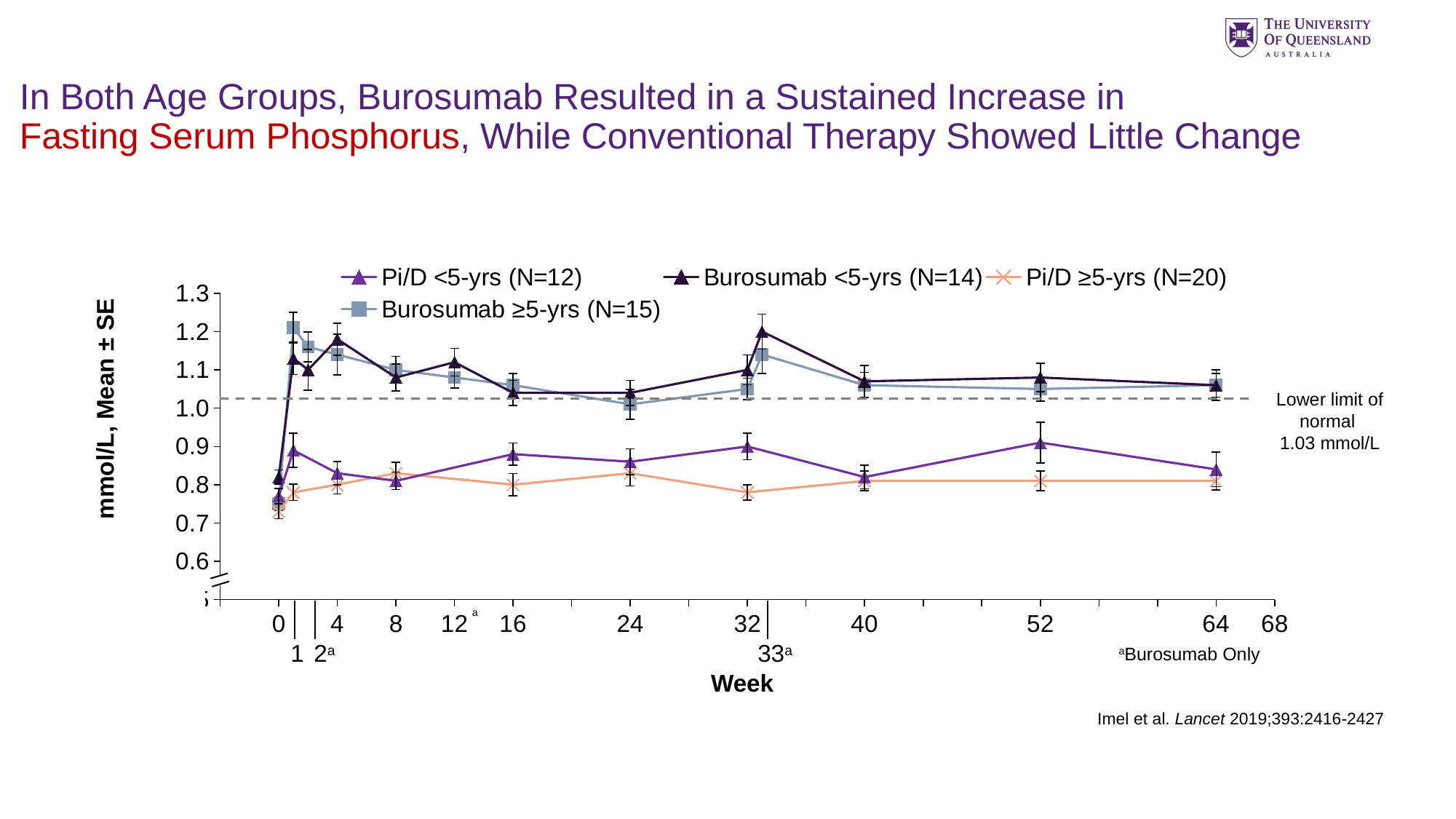
What kind of chart is shown on the slide? line chart How many series does the legend list? 4 What value is given for the lower limit of normal marked by the dashed line? 1.03 mmol/L What is the label on the y axis? mmol/L, Mean ± SE At week 52, which is larger: Pi/D <5-yrs (N=12) or Pi/D ≥5-yrs (N=20)? Pi/D <5-yrs (N=12) At week 1, which is larger: Burosumab <5-yrs (N=14) or Burosumab ≥5-yrs (N=15)? Burosumab ≥5-yrs (N=15) Is the value for Burosumab ≥5-yrs (N=15) at week 1 greater or less than 1.1? greater Is the value for Pi/D ≥5-yrs (N=20) at week 0 greater or less than 0.8? less Is the value for Burosumab <5-yrs (N=14) at week 33 greater or less than 1.1? greater Which series has the highest value at week 33? Burosumab <5-yrs (N=14) Does the Burosumab <5-yrs (N=14) series rise or fall between week 0 and week 1? rise